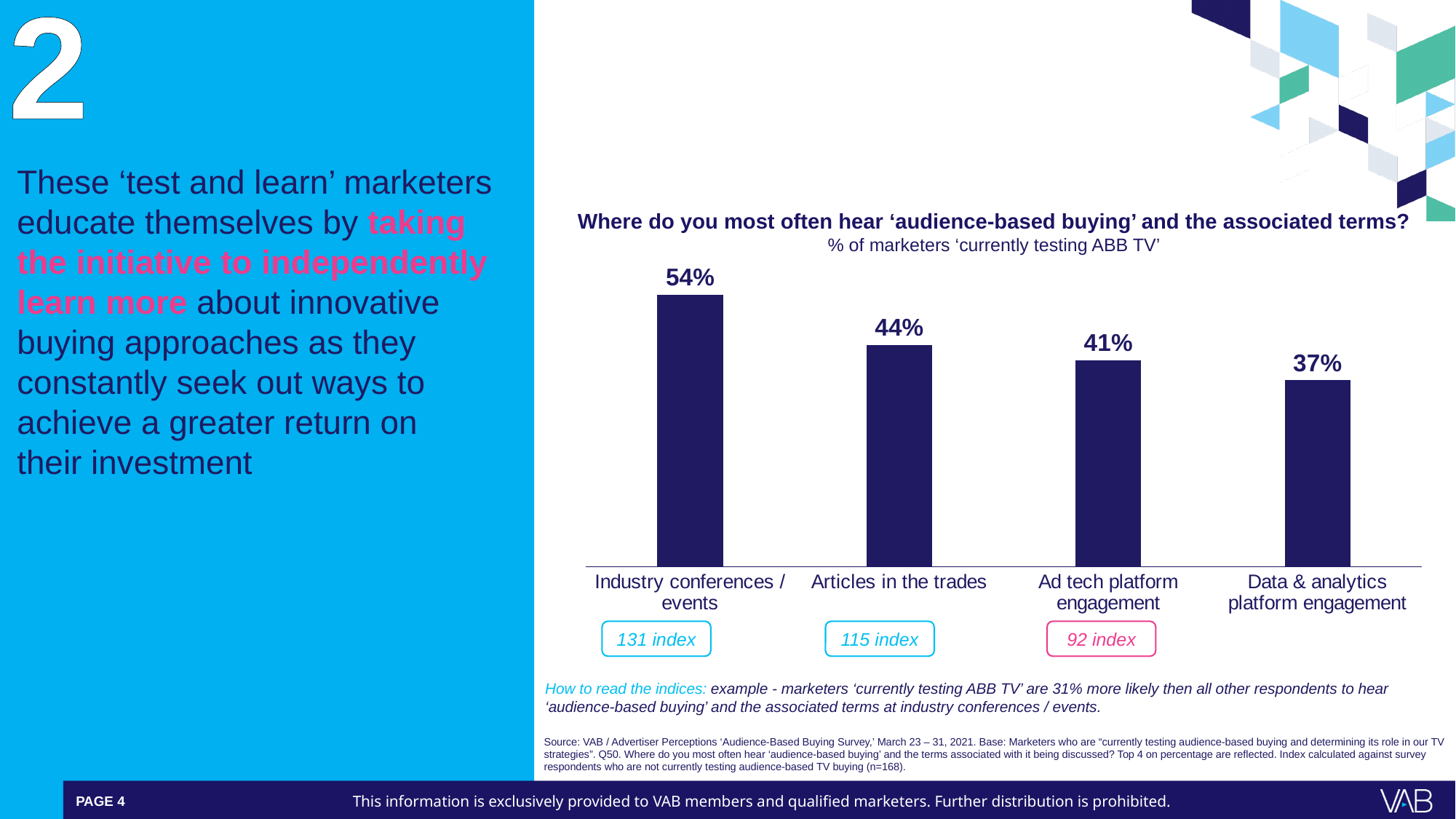
Which is larger, the value for 'Articles in the trades' or 'Ad tech platform engagement'? Articles in the trades What is the value for 'Ad tech platform engagement'? 41% Which category has the lowest value? Data & analytics platform engagement What is the difference between the values for 'Industry conferences / events' and 'Data & analytics platform engagement'? 17% What kind of chart is shown on the slide? Bar chart What is the value for 'Data & analytics platform engagement'? 37% What is the value for 'Articles in the trades'? 44% Which category has the highest value? Industry conferences / events What index value is shown beneath 'Industry conferences / events'? 131 index What percentage of marketers 'currently testing ABB TV' most often hear 'audience-based buying' at industry conferences / events? 54% How many categories are shown in the chart? 4 Do the values rise or fall from left to right across the categories? Fall